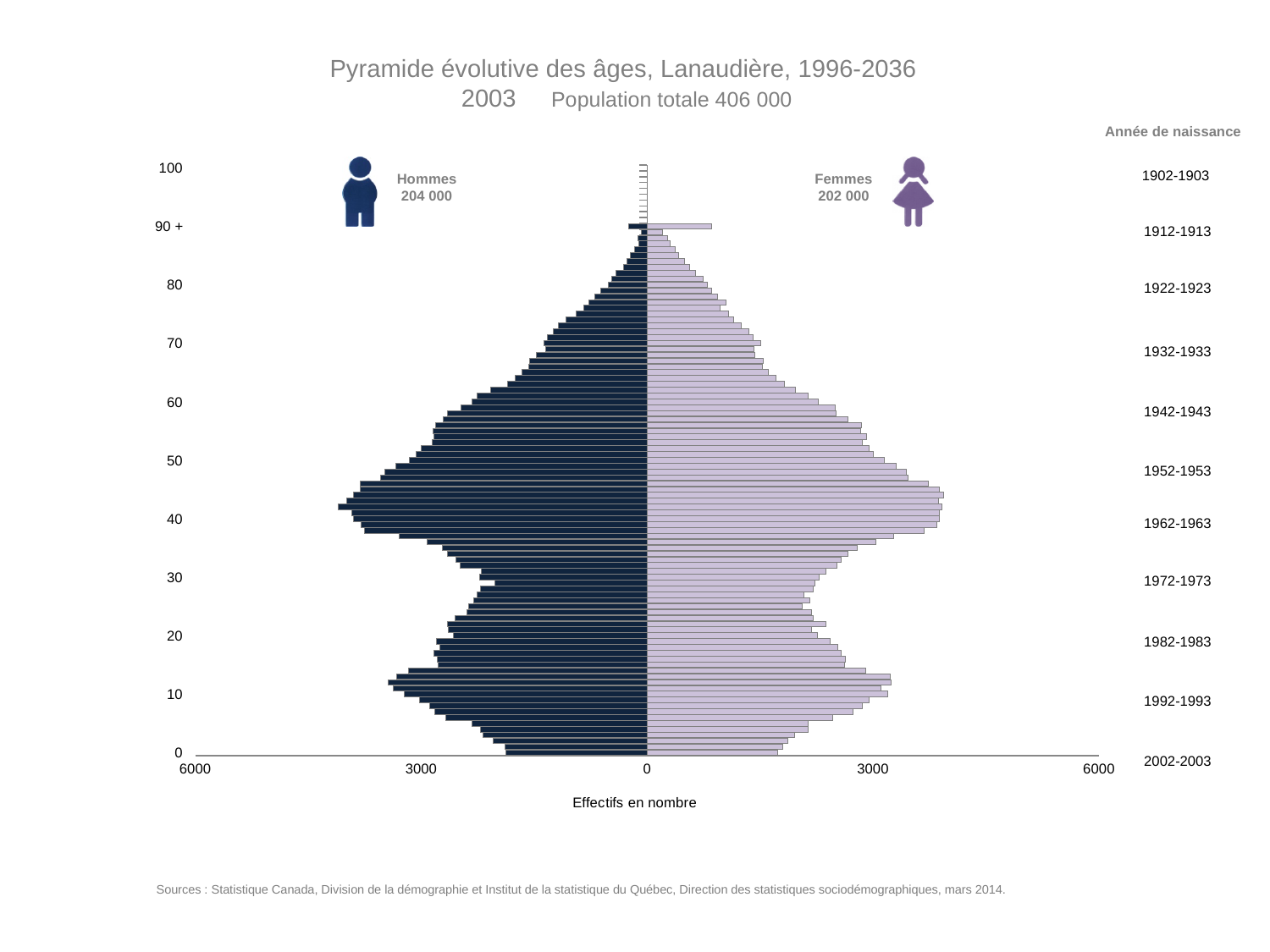
What is the difference between the Hommes total and the Femmes total? 2 000 What total population is shown for 2003? 406 000 What kind of chart is shown on the slide? bar chart What is the title of the chart? Pyramide évolutive des âges, Lanaudière, 1996-2036 How many series (population groups) does the chart show? 2 Is the value for Hommes at age 42 greater or less than 3000? greater On which side of the pyramid are the Hommes bars plotted? left What is the number shown for Femmes? 202 000 What is the number shown for Hommes? 204 000 Is the value for Hommes at age 0 greater or less than 3000? less Which group is larger, Hommes or Femmes? Hommes Do the Hommes bars get longer or shorter as age increases from 50 to 90? shorter